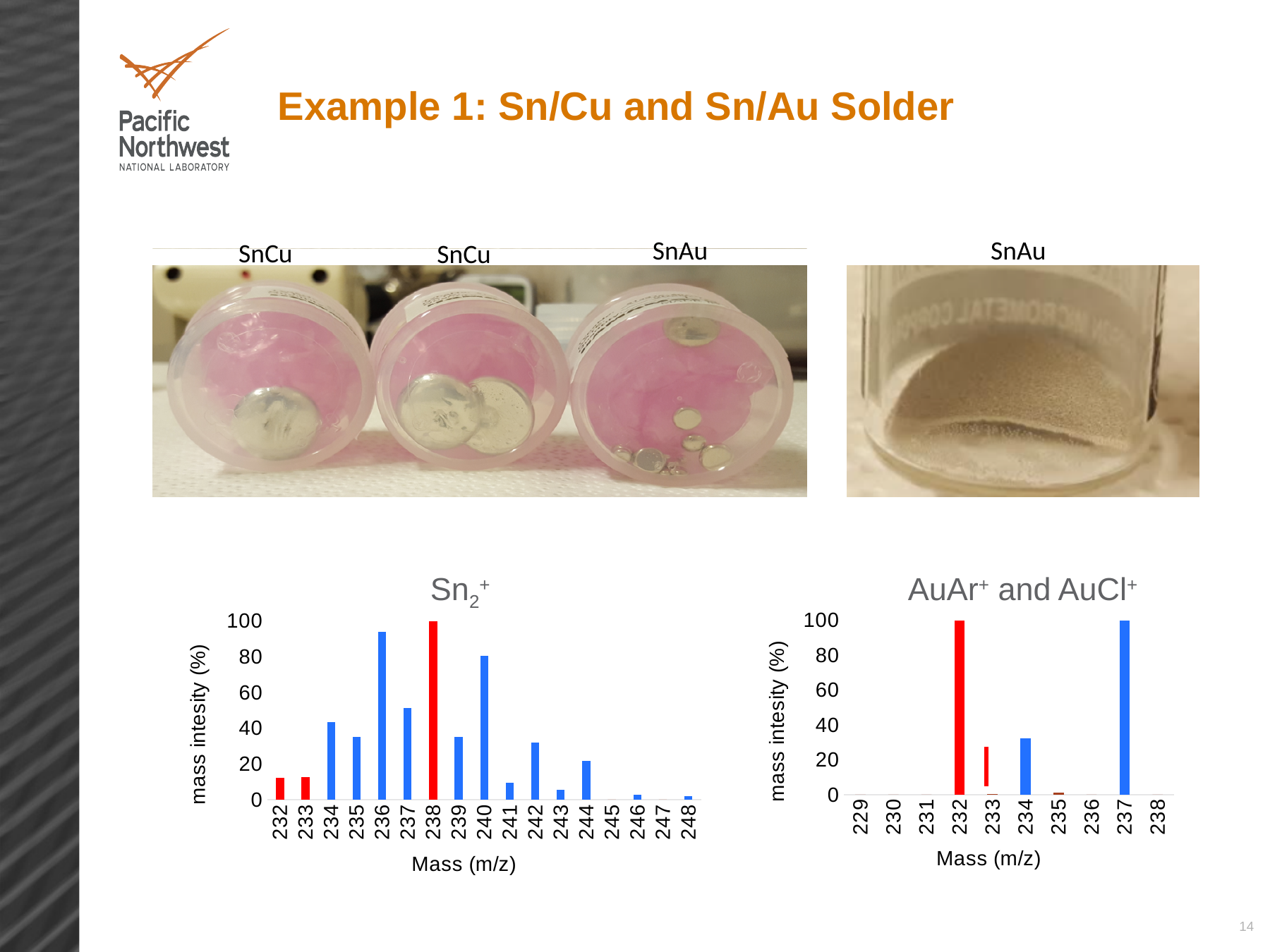
In the AuAr+ and AuCl+ chart, which has the larger mass intensity, mass 232 or mass 234? 232 In the Sn2+ chart, which mass has the highest mass intensity? 238 What kind of chart is the AuAr+ and AuCl+ chart? bar chart What is the x-axis title of the Sn2+ chart? Mass (m/z) In the Sn2+ chart, is the value at mass 236 greater or less than 80? greater In the Sn2+ chart, what is the mass intensity (%) at mass 238? 100 In the AuAr+ and AuCl+ chart, is the value at mass 234 greater or less than 20? greater How many mass values are shown on the x axis of the Sn2+ chart? 17 In the Sn2+ chart, which has the larger mass intensity, mass 236 or mass 240? 236 In the AuAr+ and AuCl+ chart, is the value at mass 233 greater or less than 40? less In the AuAr+ and AuCl+ chart, what is the mass intensity (%) at mass 237? 100